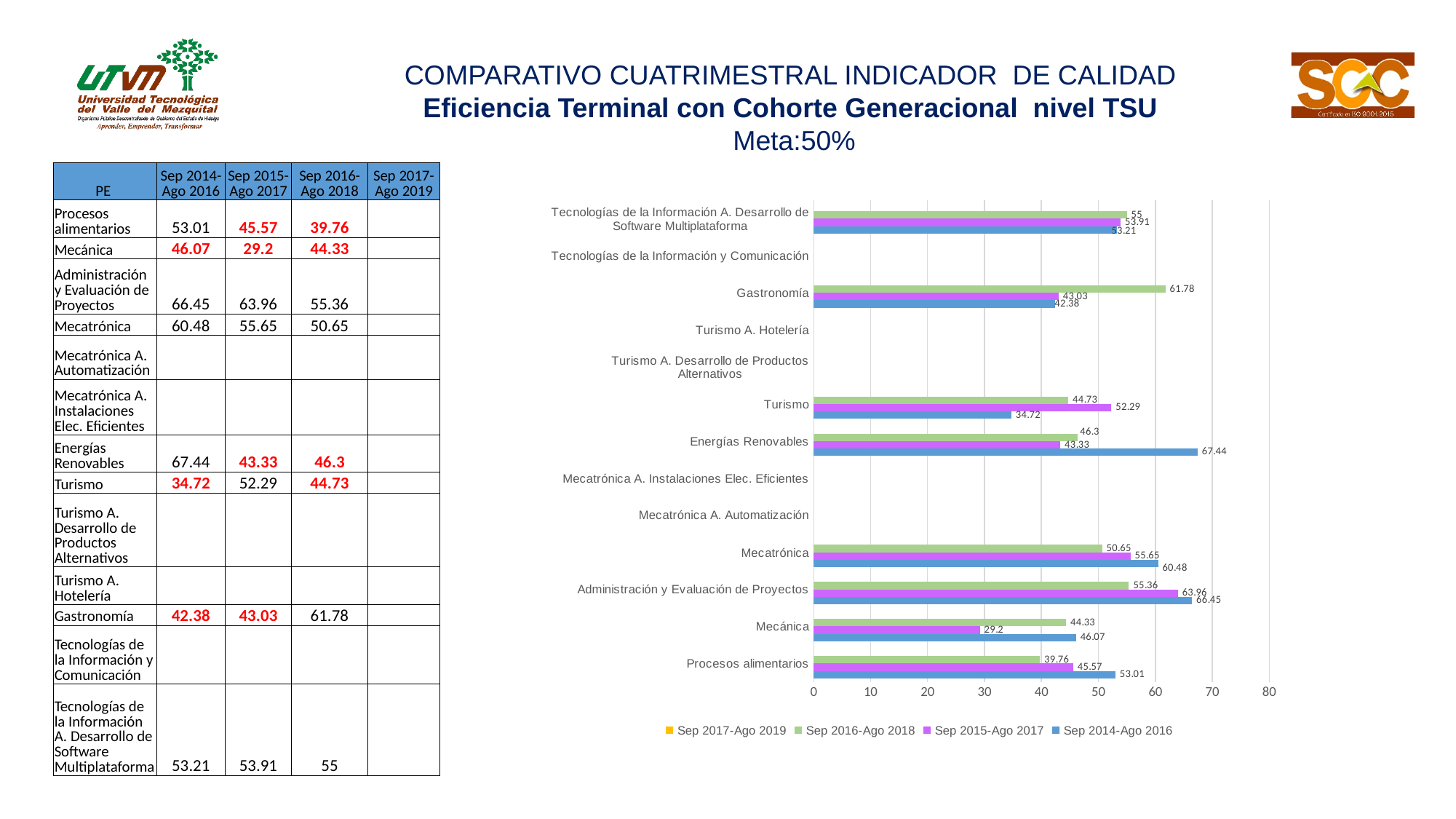
What is the value for Gastronomía in the Sep 2016-Ago 2018 series? 61.78 How many categories are listed on the vertical axis of the chart? 13 Which category has the lowest value in the Sep 2015-Ago 2017 series? Mecánica What is the value for Mecánica in the Sep 2015-Ago 2017 series? 29.2 For Procesos alimentarios, do the values rise or fall from Sep 2014-Ago 2016 through Sep 2016-Ago 2018? fall How many series does the chart legend list? 4 For Turismo, which series has the larger value: Sep 2015-Ago 2017 or Sep 2016-Ago 2018? Sep 2015-Ago 2017 What is the difference between the Sep 2014-Ago 2016 and Sep 2015-Ago 2017 values for Energías Renovables? 24.11 What is the value for Mecatrónica in the Sep 2014-Ago 2016 series? 60.48 Which category has the highest value in the Sep 2014-Ago 2016 series? Energías Renovables What kind of chart is shown on the slide? bar chart What colour represents the Sep 2014-Ago 2016 series in the chart? blue